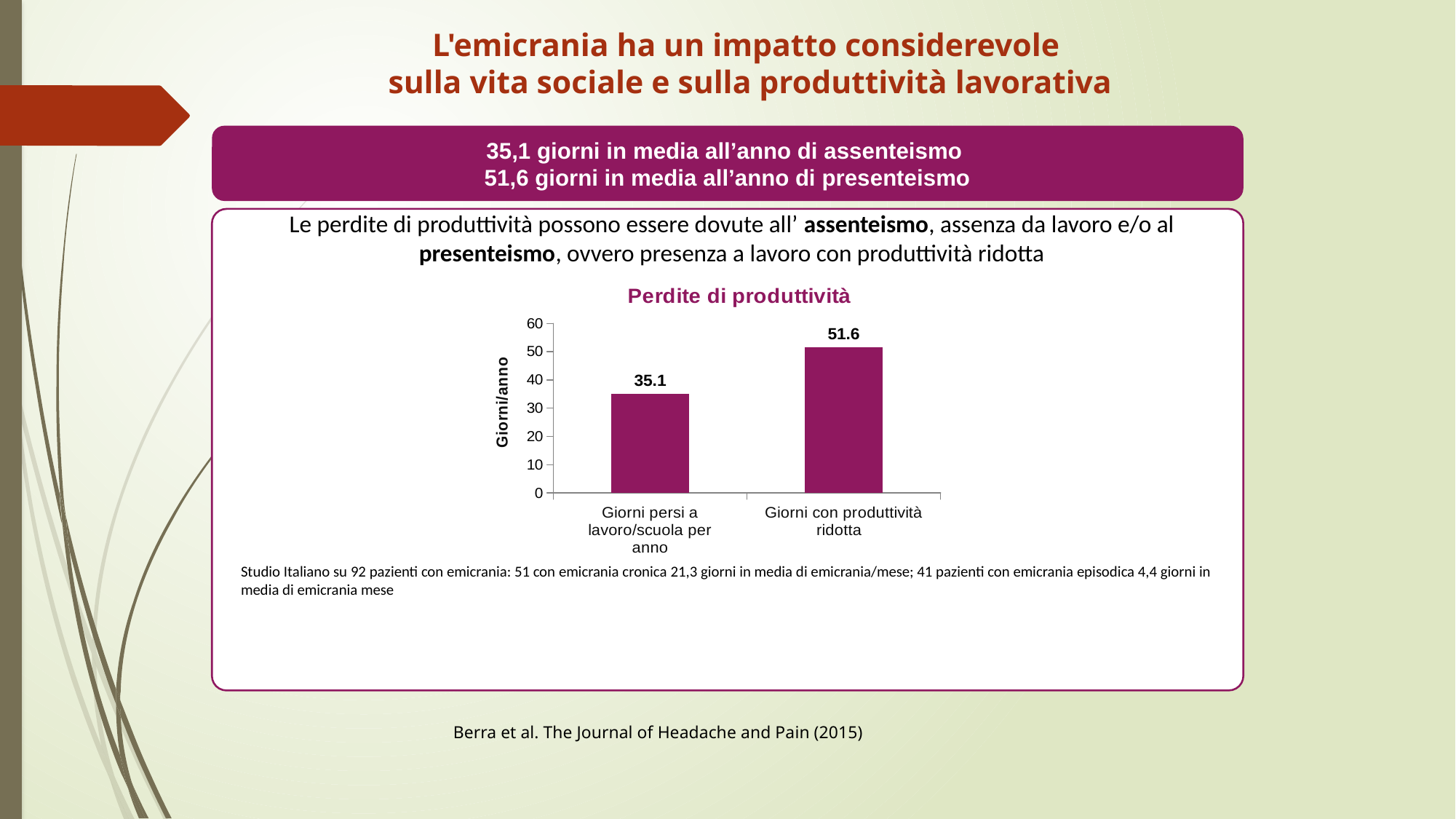
How many categories are shown in the chart? 2 Is the value for 'Giorni con produttività ridotta' greater or less than 50? greater What is the title of the chart? Perdite di produttività What is the label of the vertical axis? Giorni/anno Which category has the highest value? Giorni con produttività ridotta Which category has the lowest value? Giorni persi a lavoro/scuola per anno Which is larger: 'Giorni persi a lavoro/scuola per anno' or 'Giorni con produttività ridotta'? Giorni con produttività ridotta Is the value for 'Giorni persi a lavoro/scuola per anno' greater or less than 40? less What kind of chart is shown? bar chart What is the value for 'Giorni persi a lavoro/scuola per anno'? 35.1 What is the value for 'Giorni con produttività ridotta'? 51.6 What is the difference between 'Giorni con produttività ridotta' and 'Giorni persi a lavoro/scuola per anno'? 16.5